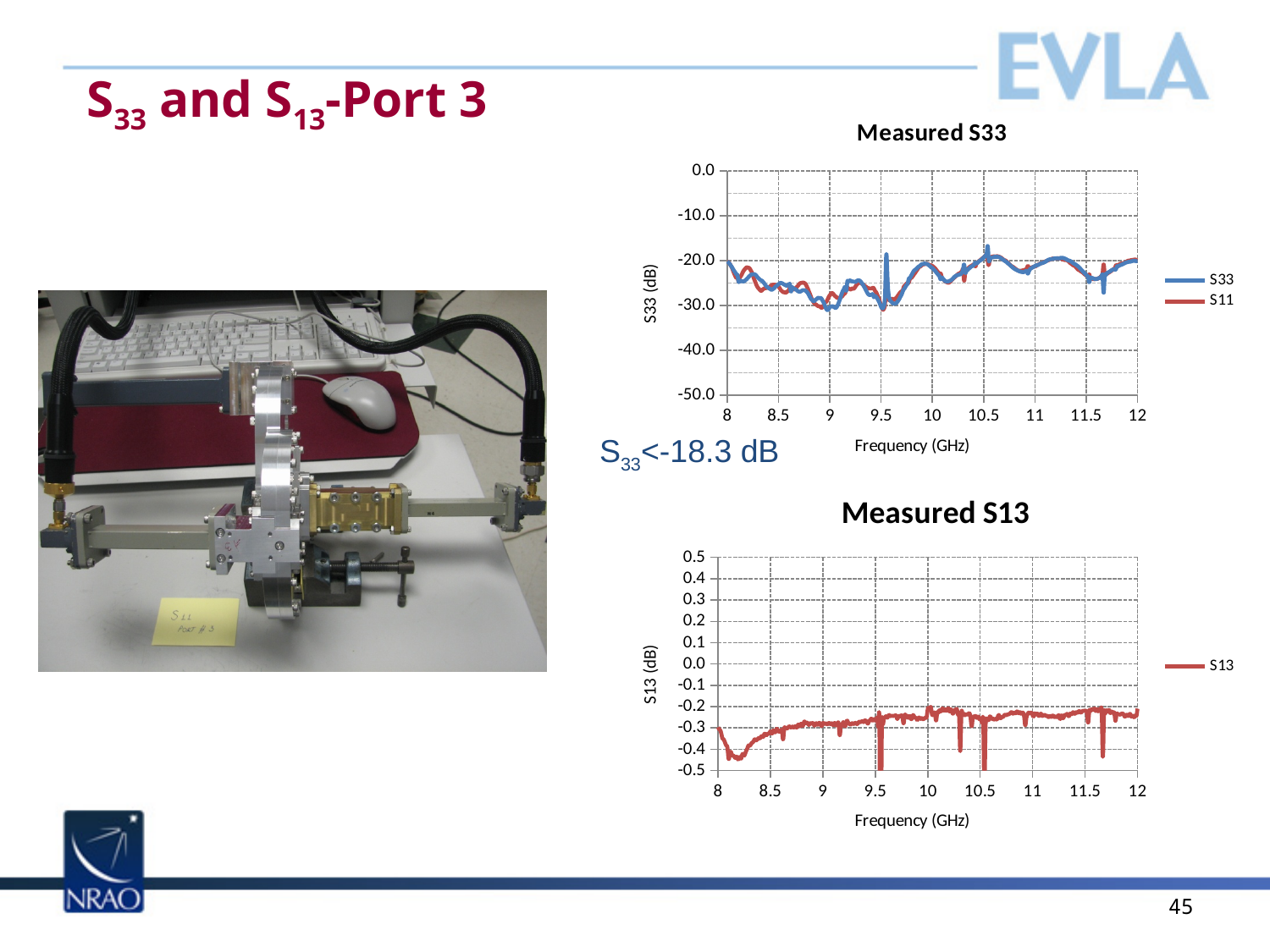
What are the two series named in the legend of the 'Measured S33' chart? S33 and S11 What kind of chart is the 'Measured S13' chart? line chart In the 'Measured S13' chart, is the S13 value at 8 GHz greater or less than 0.0 dB? less How many series does the legend of the 'Measured S33' chart list? 2 What is the x-axis label of the 'Measured S33' chart? Frequency (GHz) In the 'Measured S13' chart, do the S13 values generally rise or fall from 8 GHz to 12 GHz? rise How many series does the legend of the 'Measured S13' chart list? 1 In the 'Measured S33' chart, is the S33 value at 9 GHz greater or less than -40.0 dB? greater In the 'Measured S33' chart, is the S33 value at 9 GHz greater or less than -20.0 dB? less What kind of chart is the 'Measured S33' chart? line chart In the 'Measured S33' chart, does the S33 curve rise or fall between 9 GHz and 10 GHz? rise